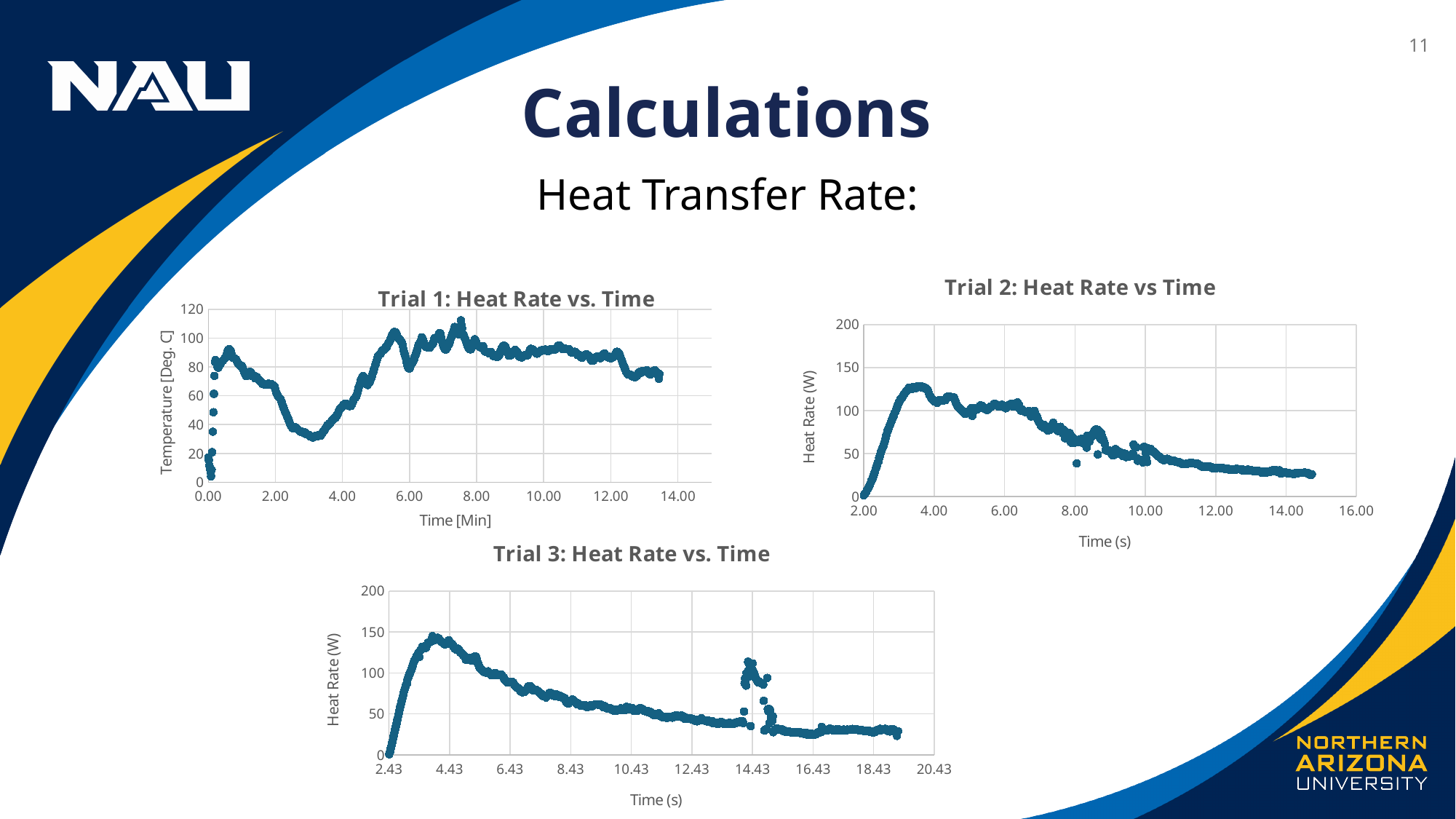
In the 'Trial 2: Heat Rate vs Time' chart, what is the label on the horizontal axis? Time (s) In the 'Trial 2: Heat Rate vs Time' chart, is the value at 14.00 s greater or less than 50? less In the 'Trial 3: Heat Rate vs. Time' chart, do the values rise or fall between 4.43 s and 12.43 s? fall In the 'Trial 1: Heat Rate vs. Time' chart, is the value at 10.00 minutes greater or less than 80? greater In the 'Trial 2: Heat Rate vs Time' chart, is the highest plotted value greater or less than 150? less How many charts are shown on the slide? 3 In the 'Trial 1: Heat Rate vs. Time' chart, what is the label on the vertical axis? Temperature [Deg. C] In the 'Trial 2: Heat Rate vs Time' chart, do the values rise or fall between 4.00 s and 14.00 s? fall What kind of chart is 'Trial 1: Heat Rate vs. Time'? scatter chart